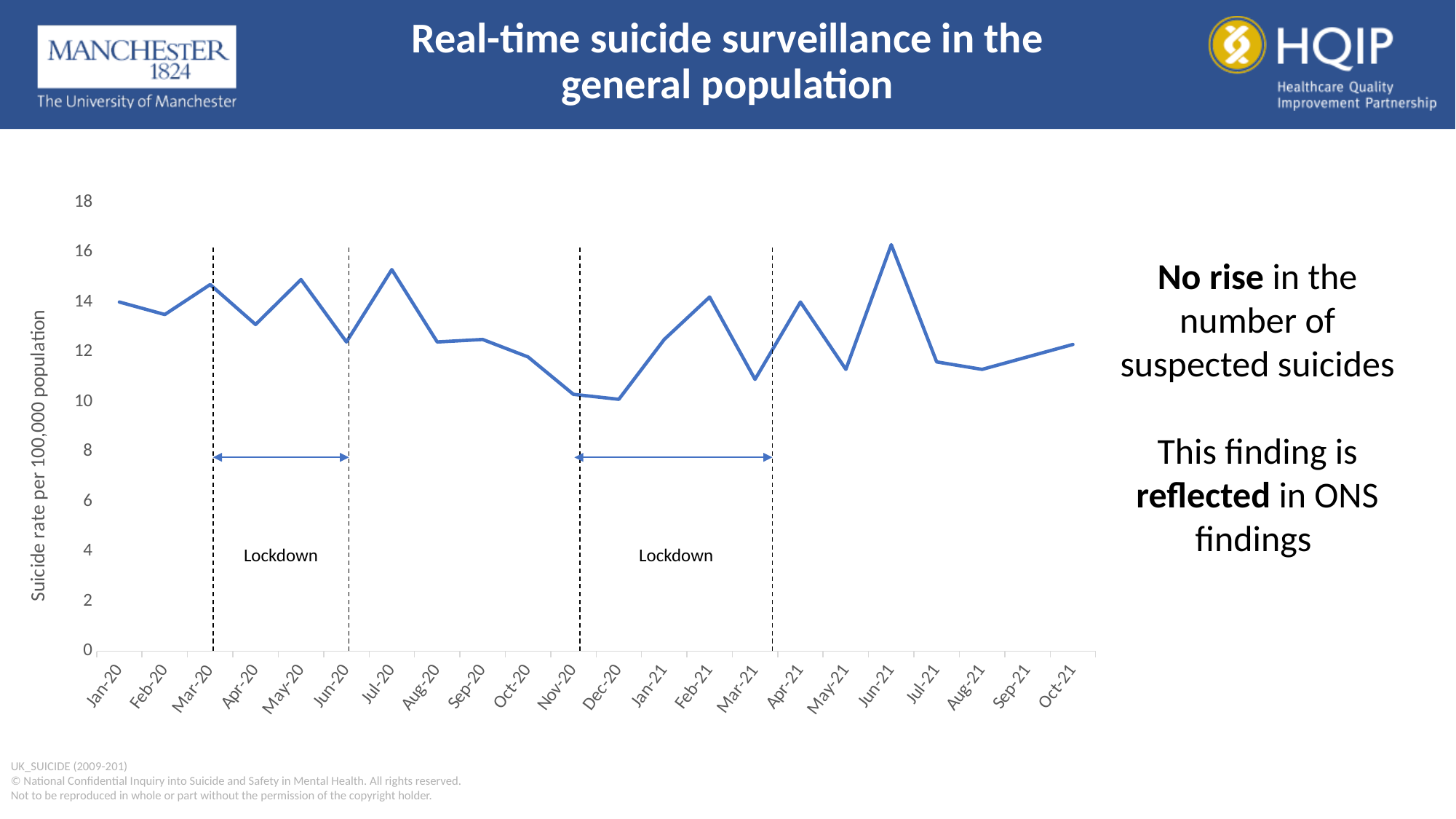
Does the suicide rate rise or fall from Jul-20 to Dec-20? fall Is the value for Dec-20 greater or less than 12? less Is the value for Jan-20 greater or less than 12? greater Is the value for Jun-21 greater or less than 14? greater How many lockdown periods are marked on the chart? 2 How many monthly data points are plotted on the chart? 22 Which month has the highest suicide rate on the chart? Jun-21 What kind of chart is shown on the slide? line chart What is the label on the vertical axis of the chart? Suicide rate per 100,000 population Which is larger, the value for Jun-21 or the value for Jul-21? Jun-21 Which is larger, the value for Jul-20 or the value for Aug-20? Jul-20